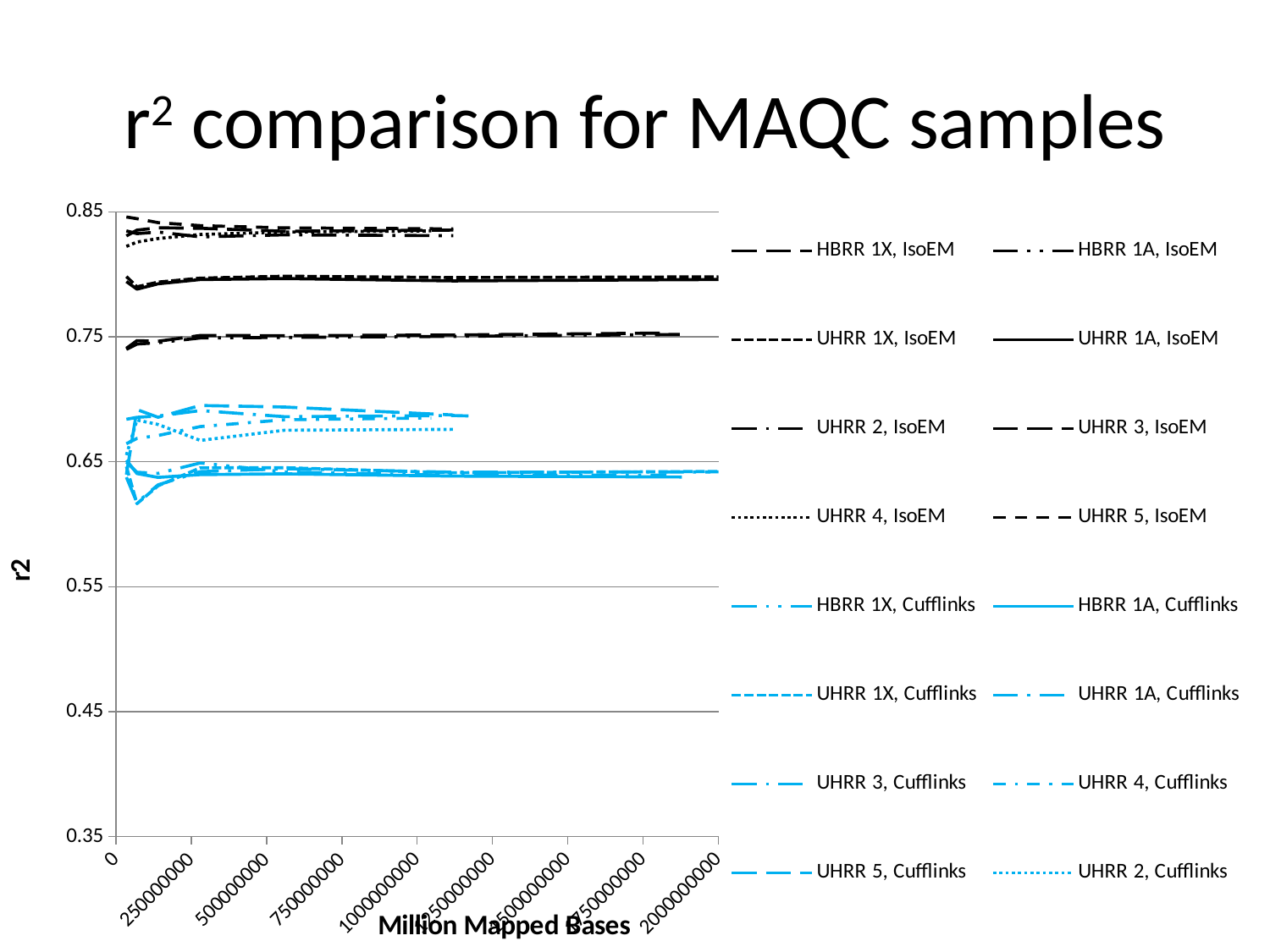
Which series has the larger r2 at 1000000000 mapped bases, UHRR 1A, IsoEM or HBRR 1A, Cufflinks? UHRR 1A, IsoEM What is the title of the chart? r2 comparison for MAQC samples Is the value for UHRR 2, Cufflinks at 1000000000 mapped bases greater or less than 0.65? greater Is the value for HBRR 1A, Cufflinks at 1000000000 mapped bases greater or less than 0.65? less How many series does the legend list? 16 What is the label of the x axis? Million Mapped Bases What is the lowest value shown on the y axis? 0.35 What kind of chart is shown on the slide? line chart Do the IsoEM series rise, fall, or stay roughly flat as Million Mapped Bases increases beyond 250000000? stay roughly flat Which series has the larger r2 at 1000000000 mapped bases, UHRR 2, IsoEM or UHRR 2, Cufflinks? UHRR 2, IsoEM Is the value for UHRR 1A, IsoEM at 1000000000 mapped bases greater or less than 0.85? less